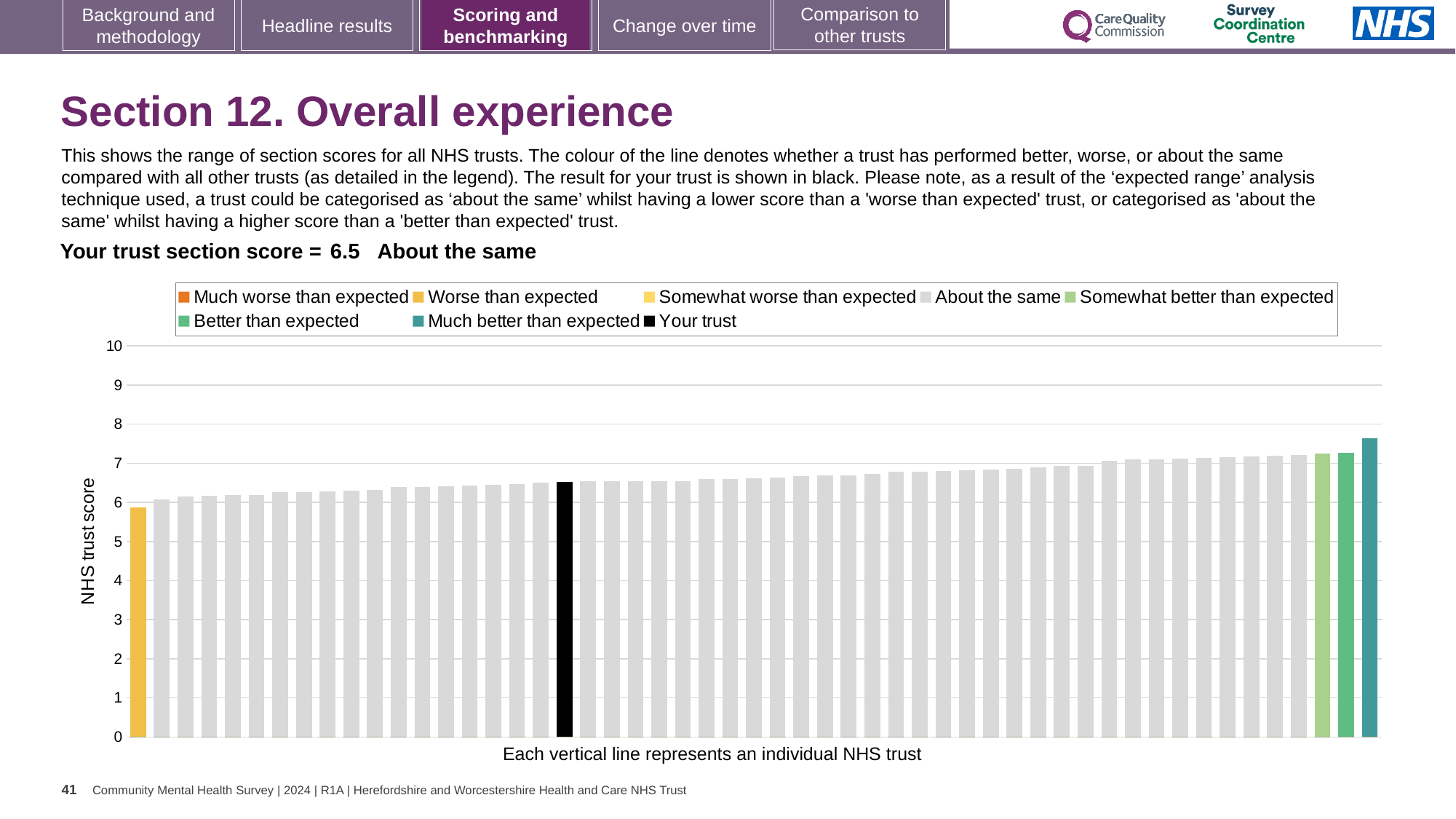
Is the value for the rightmost bar greater or less than 7? greater Which legend category does the highest bar belong to? Much better than expected Which performance category is your trust placed in? About the same Which legend category does the lowest bar belong to? Worse than expected Is the value for the leftmost bar greater or less than 5? greater What is the label on the vertical axis? NHS trust score Is the value for the black 'Your trust' bar greater or less than 6? greater Which is larger, the value of the leftmost bar or the value of the rightmost bar? rightmost bar Do the bar values rise or fall from left to right along the x axis? rise How many entries does the legend list? 8 What kind of chart is shown on the slide? bar chart What is the section score for your trust? 6.5